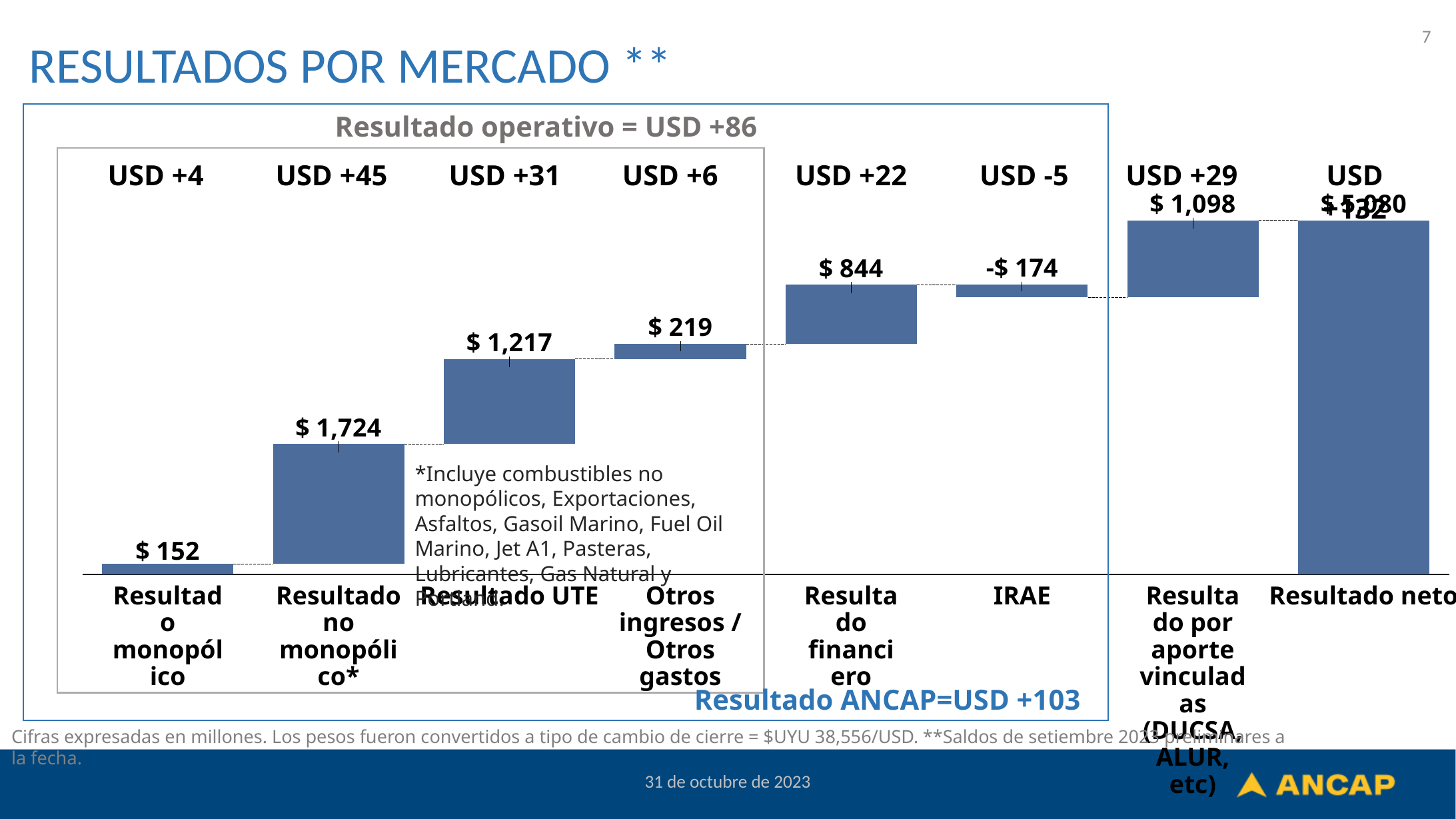
What is the value shown for Resultado financiero? $ 844 What is the value shown for Resultado UTE? $ 1,217 What is the difference between the Resultado no monopólico* value and the Resultado UTE value? $ 507 What is the Resultado operativo figure stated above the chart? USD +86 What is the USD figure shown above the Resultado no monopólico* bar? USD +45 What is the value shown for IRAE? -$ 174 What is the value shown for Resultado no monopólico*? $ 1,724 Which is larger, the value for Resultado financiero or the value for Otros ingresos / Otros gastos? Resultado financiero What is the value shown for Resultado monopólico? $ 152 How many categories are shown on the x axis? 8 Which category has the lowest (only negative) value? IRAE What kind of chart is shown on the slide? Bar chart (waterfall)